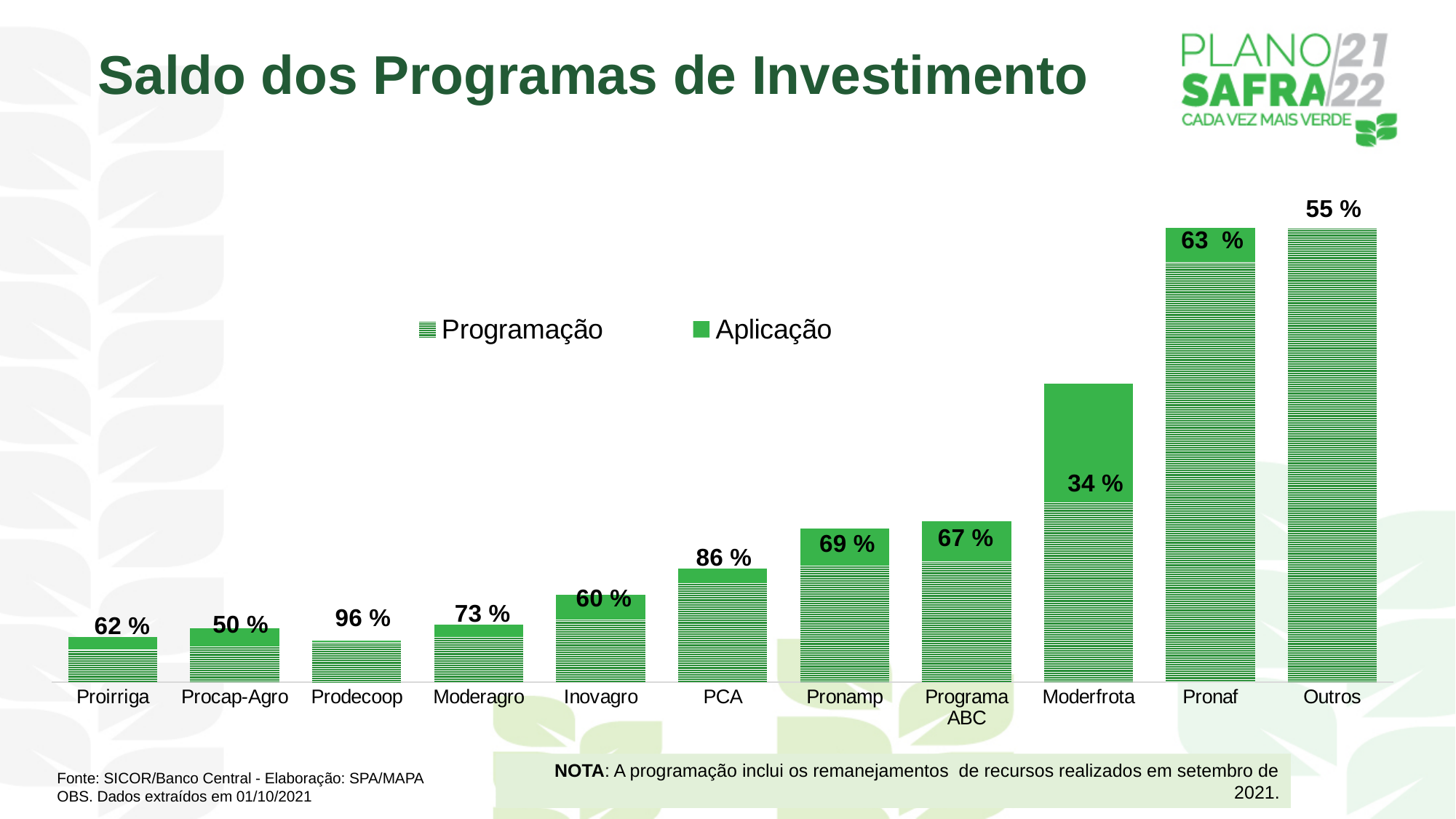
Which program has the lowest percentage label on the chart? Moderfrota What percentage label is shown for Moderfrota? 34 % What percentage label is shown for Inovagro? 60 % What are the two series named in the legend? Programação and Aplicação What is the difference in percentage points between the labels for Prodecoop and Moderfrota? 62 How many programs (categories) are shown on the x axis? 11 What kind of chart is shown on the slide? Bar chart What percentage label is shown above the Prodecoop bar? 96 % How many series does the legend list? 2 What percentage label is shown for Pronaf? 63 % Which has the higher percentage label, Pronamp or Programa ABC? Pronamp Which program has the highest percentage label on the chart? Prodecoop